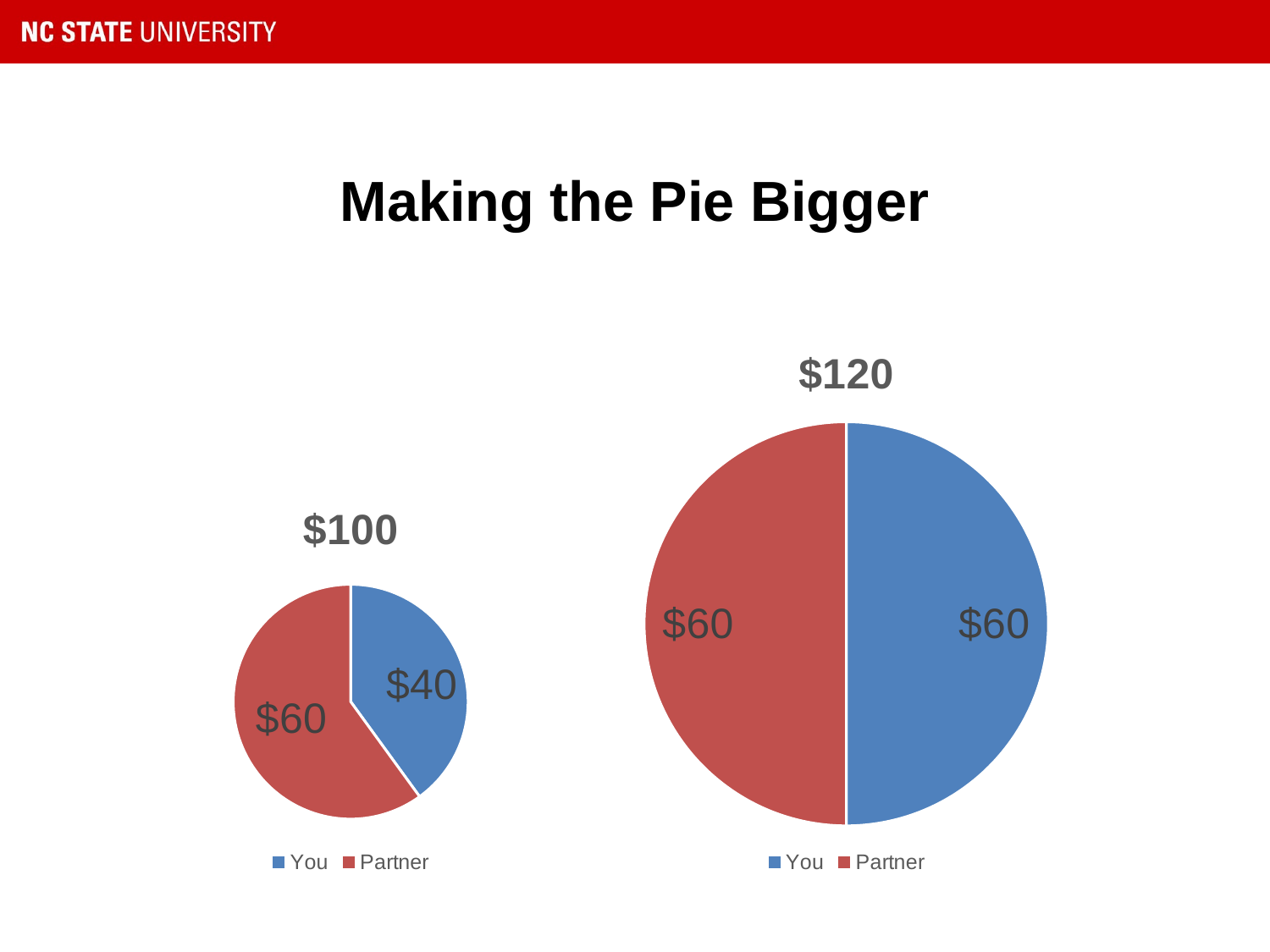
In the $100 pie chart, which category has the smaller slice? You In the $120 pie chart, what colour is the You slice? Blue In the $100 pie chart, what is the value for Partner? $60 In the $100 pie chart, which category has the larger slice? Partner In the $120 pie chart, what is the value for You? $60 In the $120 pie chart, what share of the pie does Partner represent? 50% How many categories does the $100 pie chart have? 2 What kind of chart is the $120 chart? Pie chart In the $100 pie chart, what is the value for You? $40 In the $100 pie chart, what is the difference between the Partner value and the You value? $20 In the $100 pie chart, what share of the pie does You represent? 40% How many entries does the legend of the $120 pie chart list? 2